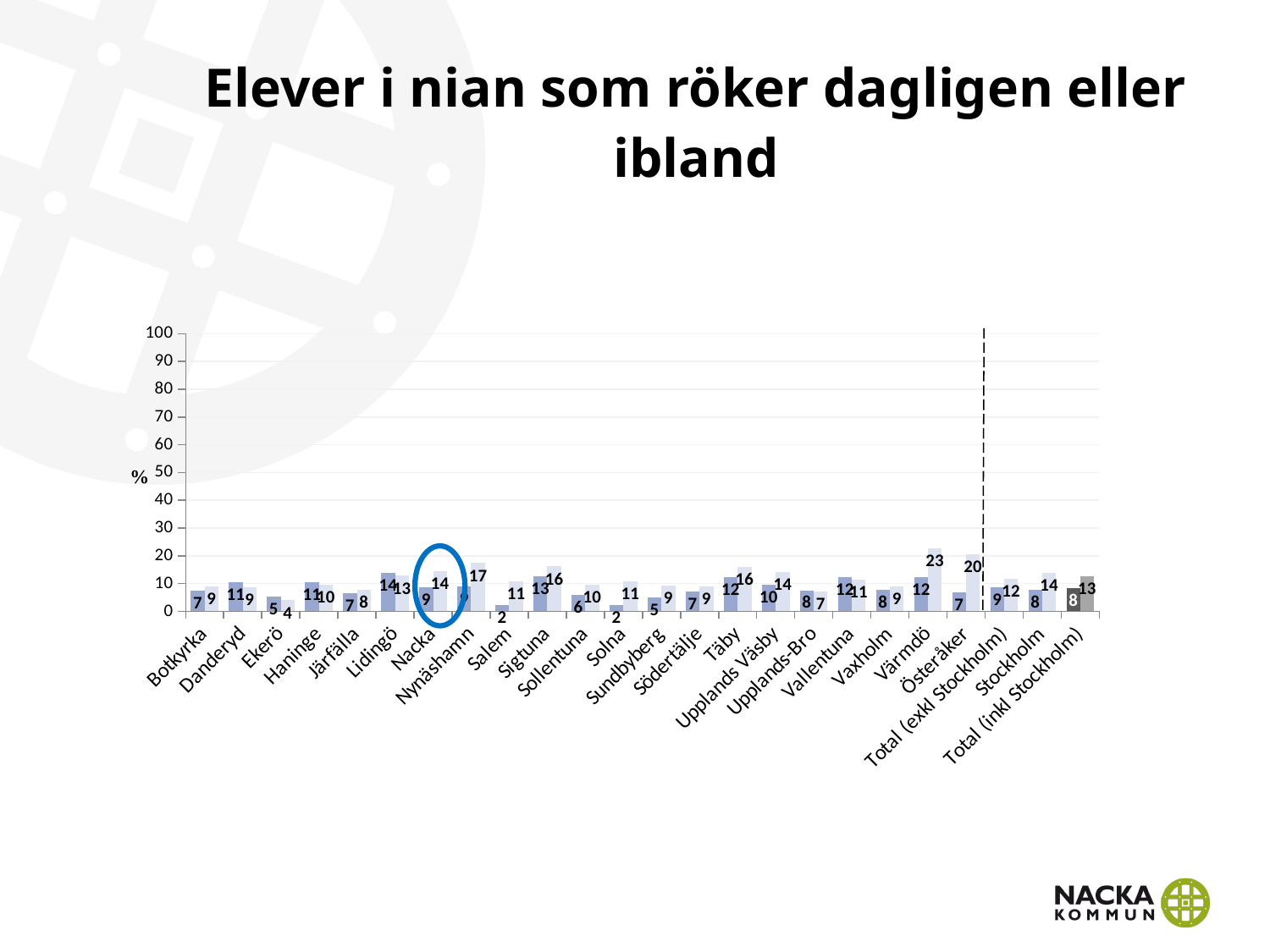
What is the title of the chart? Elever i nian som röker dagligen eller ibland Which category has the highest lighter blue bar? Värmdö What type of chart is shown on the slide? bar chart Is the value of the lighter blue bar for Värmdö greater or less than 30? less Which category has the lowest lighter blue bar? Ekerö What is the value of the lighter blue bar for Nacka? 14 What is the difference between the lighter blue bar and the darker blue bar for Österåker? 13 What is the value of the darker blue bar for Salem? 2 Which is larger for Danderyd, the darker blue bar or the lighter blue bar? the darker blue bar What is the value of the lighter blue bar for Värmdö? 23 What is the value of the darker blue bar for Lidingö? 14 How many categories are shown on the x axis? 24